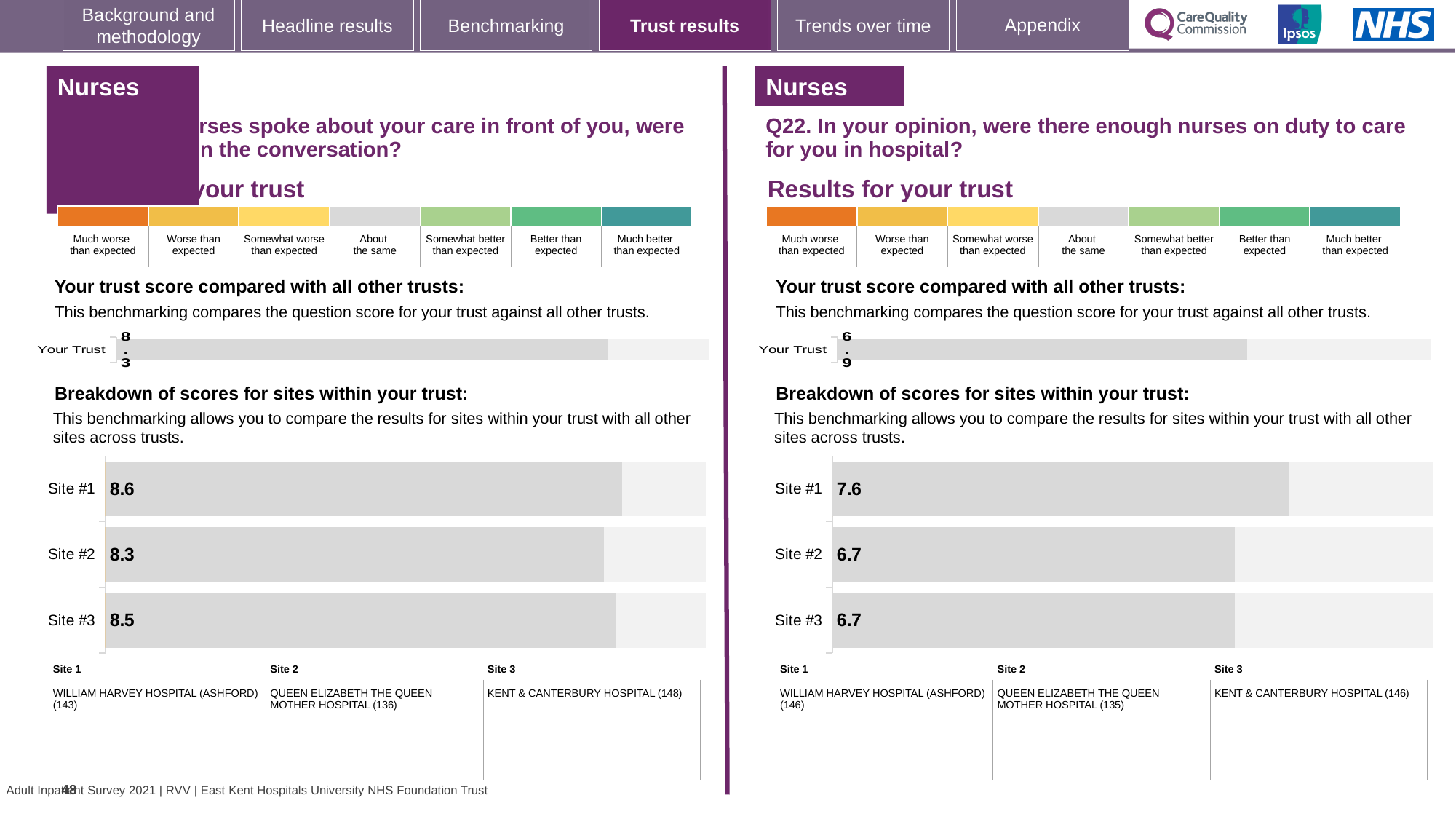
In the left-hand site breakdown chart, what is the difference between the scores for Site #1 and Site #3? 0.1 Is the Site #3 score higher in the left-hand site breakdown chart or in the right-hand (Q22) site breakdown chart? Left-hand chart In the left-hand 'Breakdown of scores for sites within your trust' chart, what is the score for Site #2? 8.3 In the left-hand 'Your trust score compared with all other trusts' chart, what is the score for Your Trust? 8.3 In the right-hand (Q22) 'Breakdown of scores for sites within your trust' chart, what is the score for Site #1? 7.6 What type of chart is used for the 'Breakdown of scores for sites within your trust' on the right-hand side of the slide? Bar chart In the left-hand 'Breakdown of scores for sites within your trust' chart, which site has the highest score? Site #1 In the right-hand (Q22) 'Breakdown of scores for sites within your trust' chart, which site has the highest score? Site #1 How many sites are shown in the right-hand (Q22) 'Breakdown of scores for sites within your trust' chart? 3 In the right-hand (Q22) site breakdown chart, what is the difference between the scores for Site #1 and Site #2? 0.9 In the left-hand 'Breakdown of scores for sites within your trust' chart, which site has the lowest score? Site #2 In the right-hand (Q22) 'Your trust score compared with all other trusts' chart, what is the score for Your Trust? 6.9